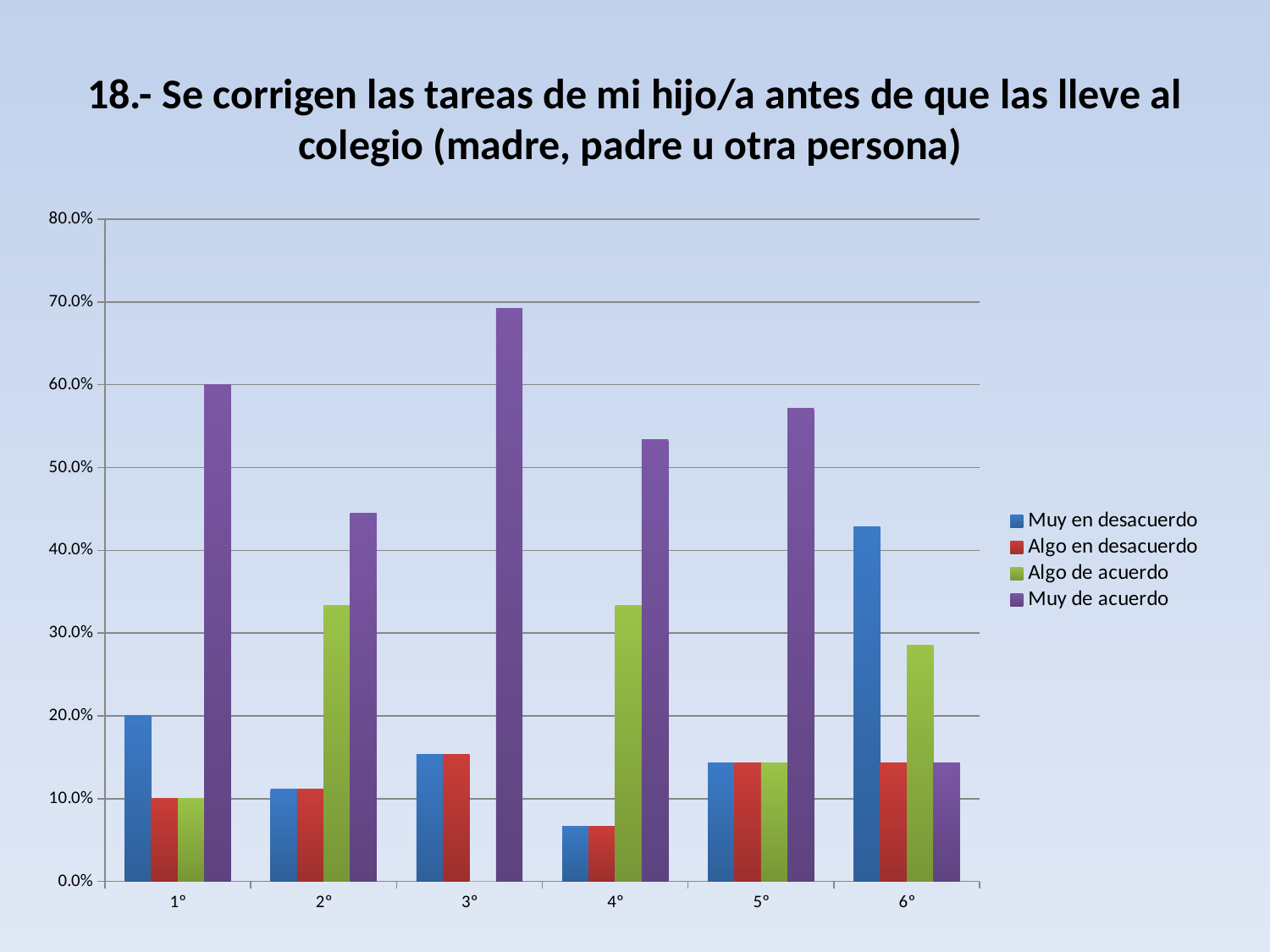
What is the value of 'Muy en desacuerdo' for 1°? 20.0% How many categories are shown on the x axis? 6 Which category has the lowest 'Muy de acuerdo' value? 6° Which is larger for 6°: 'Muy en desacuerdo' or 'Algo de acuerdo'? Muy en desacuerdo Is the value of 'Muy de acuerdo' for 2° greater or less than 40.0%? greater Which category has the highest 'Muy de acuerdo' value? 3° What is the value of 'Algo en desacuerdo' for 1°? 10.0% What kind of chart is shown on the slide? bar chart What is the value of 'Muy de acuerdo' for 1°? 60.0% Which category has the highest 'Muy en desacuerdo' value? 6° Is the value of 'Muy en desacuerdo' for 4° greater or less than 10.0%? less How many series does the legend list? 4